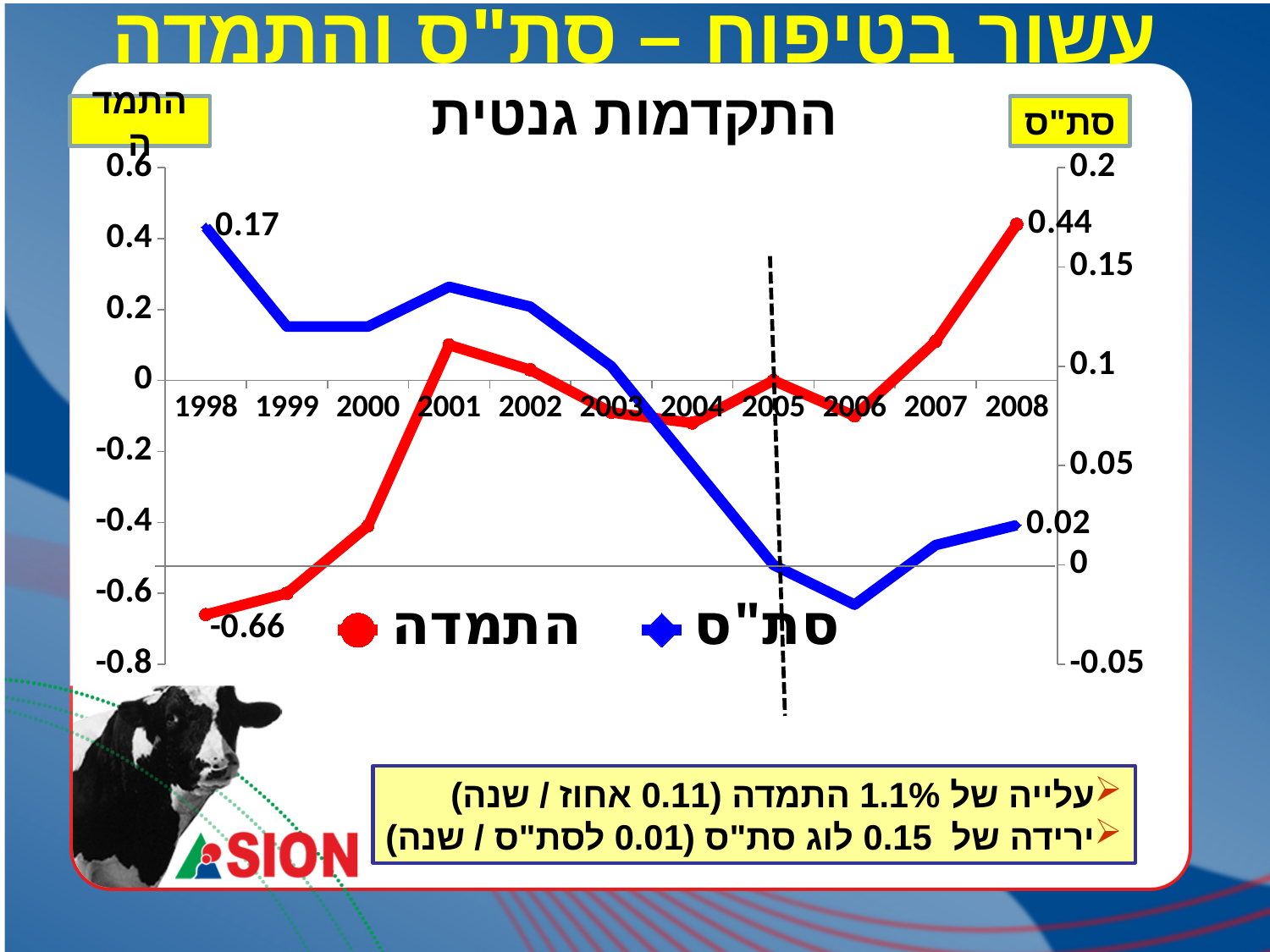
Is the value for התמדה in 2000 greater or less than 0? less What is the value of התמדה in 1998? -0.66 How many years are shown on the x axis? 11 How many series does the legend list? 2 In which year is התמדה at its highest? 2008 What is the value of סת"ס in 1998? 0.17 What is the difference between the סת"ס value in 1998 and in 2008? 0.15 What is the value of התמדה in 2008? 0.44 In which year is סת"ס at its lowest? 2006 By how much did התמדה change from 1998 to 2008? 1.10 What is the value of סת"ס in 2008? 0.02 What kind of chart is shown on the slide? line chart